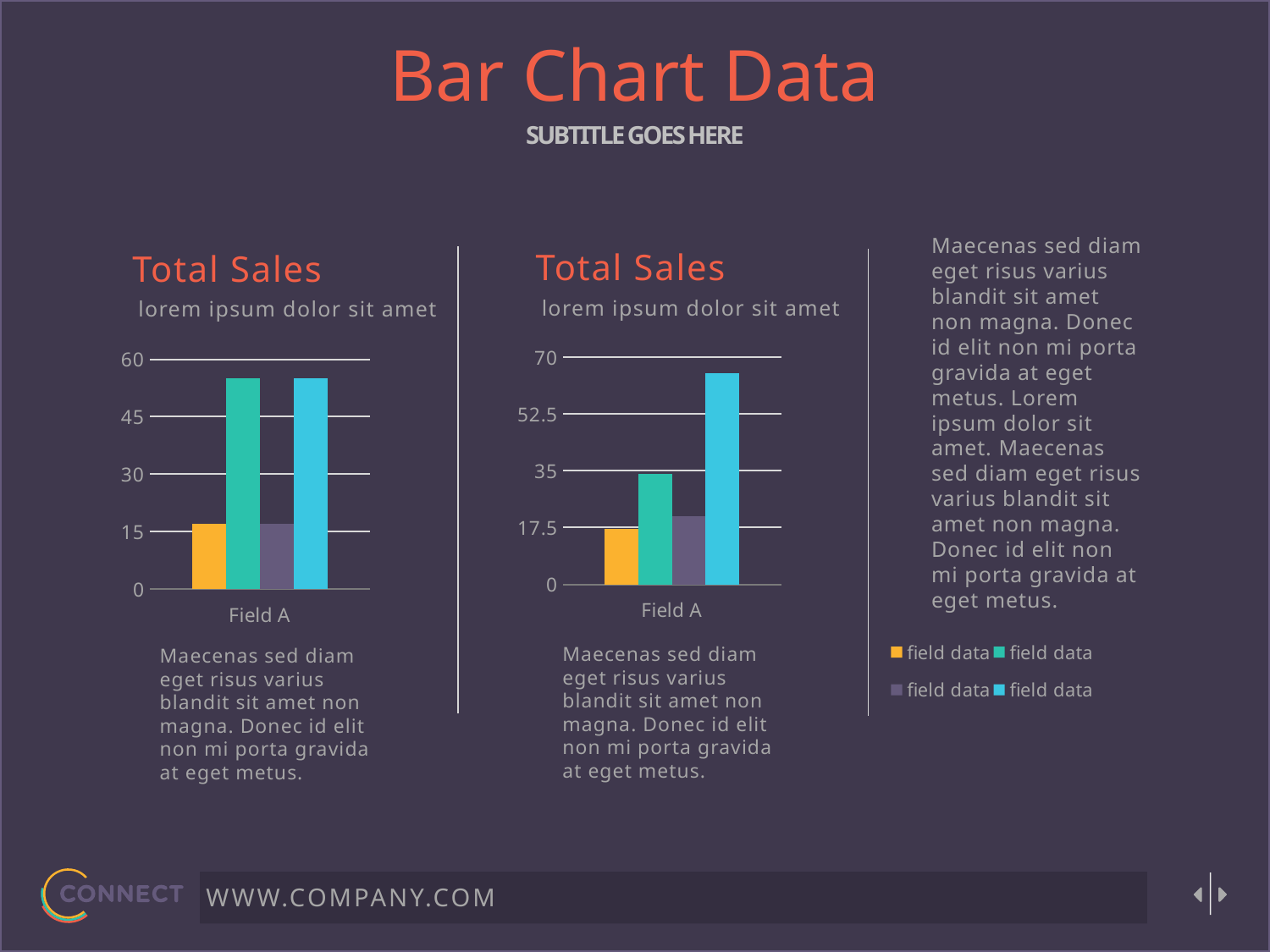
In the middle Total Sales chart, is the value of the purple bar greater or less than 35? less In the left-hand Total Sales chart, is the value of the orange bar greater or less than 30? less In the left-hand Total Sales chart, is the value of the green bar greater or less than 45? greater What is the category label on the x axis of the middle Total Sales chart? Field A How many series does the legend on the slide list? 4 What kind of chart is the left-hand Total Sales chart? bar chart What is the highest value shown on the y axis of the middle Total Sales chart? 70 In the middle Total Sales chart, which bar is the highest? the cyan bar In the left-hand Total Sales chart, which is larger, the green bar or the orange bar? the green bar In the middle Total Sales chart, which is larger, the green bar or the orange bar? the green bar How many categories are shown on the x axis of the left-hand Total Sales chart? 1